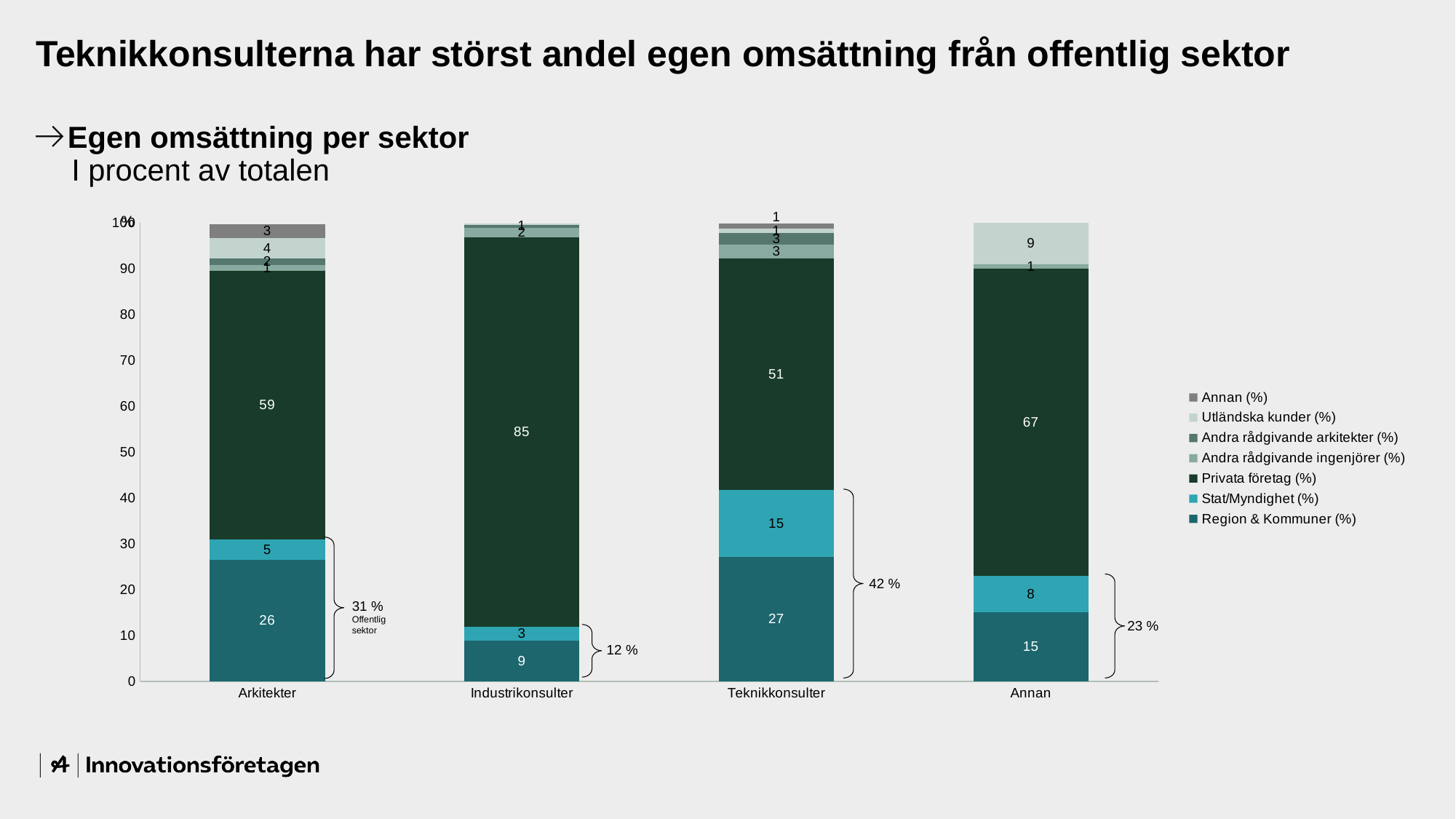
What is the difference between the Privata företag (%) values for Annan and Arkitekter? 8 Which is larger: the Stat/Myndighet (%) value for Teknikkonsulter or for Arkitekter? Teknikkonsulter Which category has the highest value for Privata företag (%)? Industrikonsulter What is the value for Region & Kommuner (%) for Teknikkonsulter? 27 How many categories are shown on the x axis? 4 What is the value for Utländska kunder (%) for Arkitekter? 4 What is the value for Privata företag (%) for Industrikonsulter? 85 What share of own turnover from the public sector (Offentlig sektor) is annotated for Teknikkonsulter? 42 % Which category has the lowest value for Region & Kommuner (%)? Industrikonsulter What is the value for Stat/Myndighet (%) for Annan? 8 How many series does the legend list? 7 What kind of chart is shown on the slide? stacked bar chart